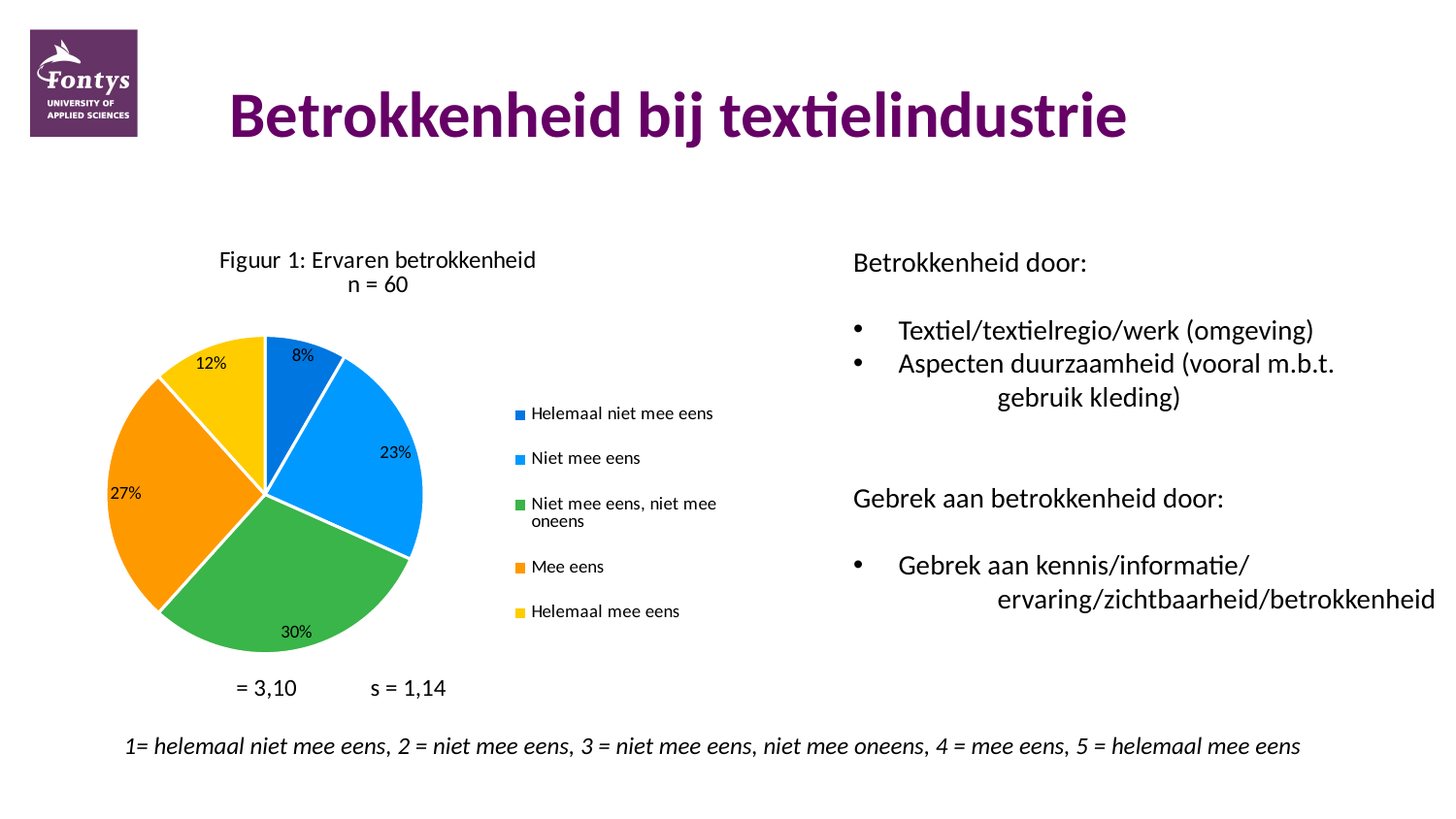
What is the title of the chart? Figuur 1: Ervaren betrokkenheid n = 60 What percentage of the pie is 'Helemaal niet mee eens'? 8% What is the difference in percentage points between 'Mee eens' and 'Helemaal mee eens'? 15 How many categories does the legend of the pie chart list? 5 What percentage of the pie is 'Mee eens'? 27% What percentage of the pie is 'Niet mee eens'? 23% What percentage of the pie is 'Niet mee eens, niet mee oneens'? 30% Which category has the smallest slice of the pie? Helemaal niet mee eens Which is larger, the slice for 'Niet mee eens' or the slice for 'Mee eens'? Mee eens Which category has the largest slice of the pie? Niet mee eens, niet mee oneens What kind of chart is shown on the slide? pie chart What percentage of the pie is 'Helemaal mee eens'? 12%